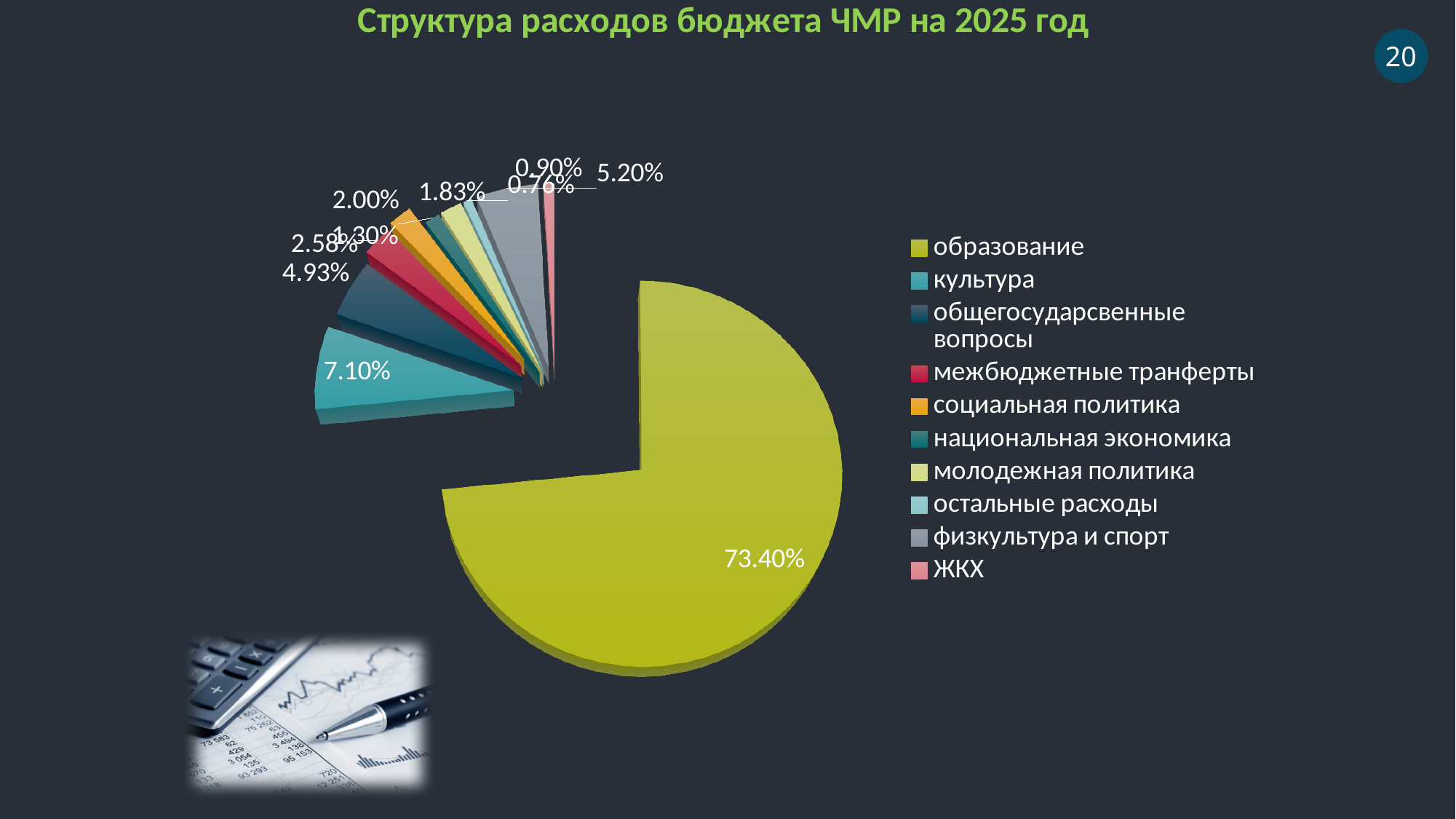
What colour is the slice for образование? yellow-green How many categories does the legend list? 10 What is the title of the chart? Структура расходов бюджета ЧМР на 2025 год What share of the budget expenditure goes to образование? 73.40% What type of chart is shown on the slide? pie chart What share of the budget expenditure goes to физкультура и спорт? 5.20% What share of the budget expenditure goes to межбюджетные транферты? 2.58% What is the difference in percentage points between the shares of образование and культура? 66.30% Which category has the largest share of the budget expenditure? образование Which has a larger share, культура or физкультура и спорт? культура What share of the budget expenditure goes to культура? 7.10% What share of the budget expenditure goes to общегосударсвенные вопросы? 4.93%